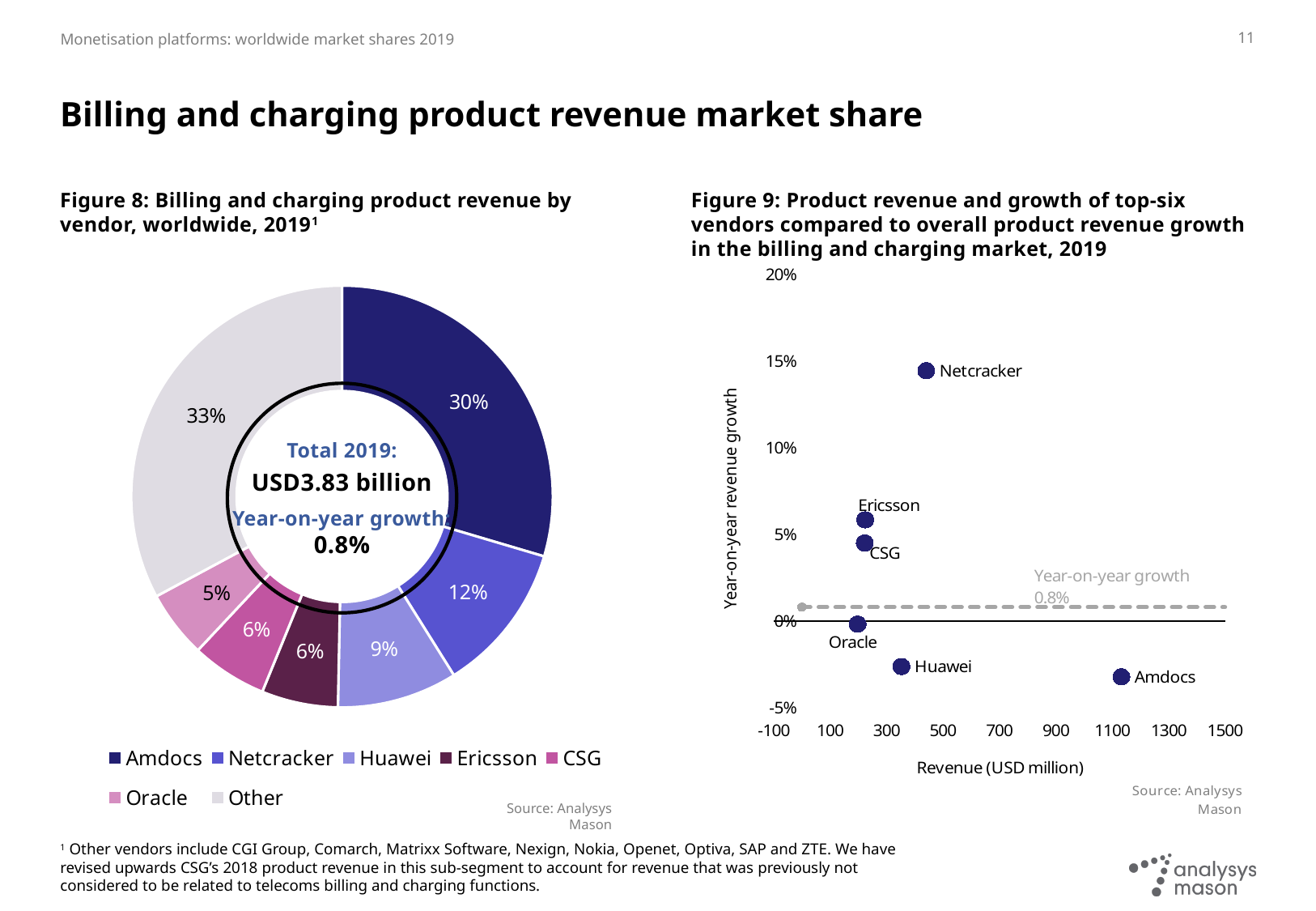
In Figure 9, is Amdocs's revenue greater or less than 900 USD million? greater In Figure 9, which has the higher year-on-year revenue growth, Ericsson or CSG? Ericsson In Figure 9, is Netcracker's year-on-year revenue growth greater or less than 10%? greater In Figure 8, what is Netcracker's share of revenue? 12% In Figure 8, what is the total 2019 revenue shown in the centre of the chart? USD3.83 billion In Figure 8, what share of billing and charging product revenue does Amdocs hold? 30% In Figure 8, which vendor has the smallest share? Oracle In Figure 8, how many percentage points larger is Amdocs's share than Netcracker's? 18 percentage points What kind of chart is Figure 8? Pie (donut) chart In Figure 8, which named vendor (excluding Other) has the largest share? Amdocs In Figure 9, which vendor has the highest year-on-year revenue growth? Netcracker In Figure 8, how many entries does the legend list? 7